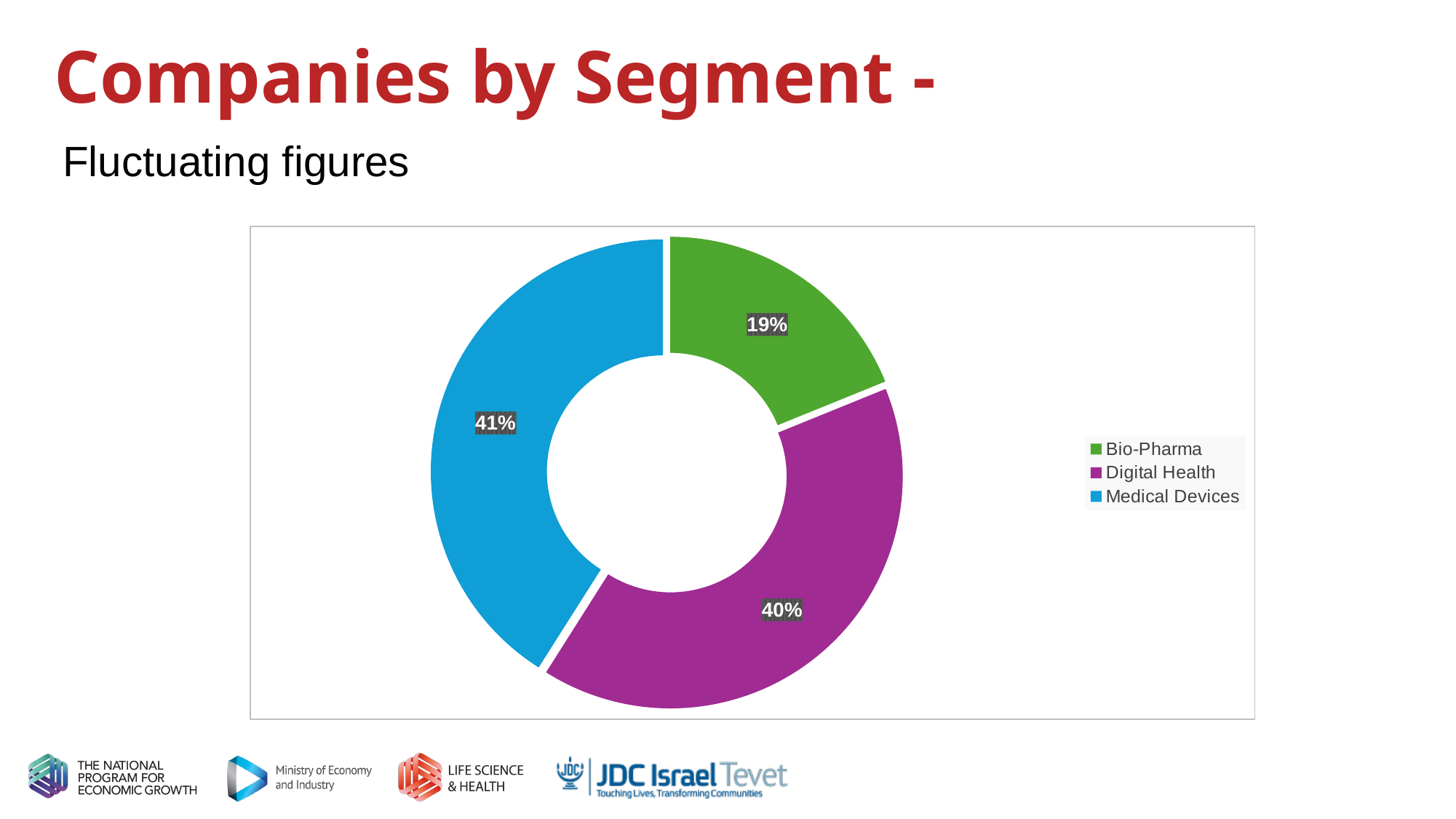
Which segment has the largest share of companies? Medical Devices Which segment has a larger share, Digital Health or Bio-Pharma? Digital Health Which segment has the smallest share of companies? Bio-Pharma How many segments are shown in the chart? 3 What is the difference in percentage points between the Medical Devices and Bio-Pharma shares? 22 What share of companies is in the Bio-Pharma segment? 19% What share of companies is in the Medical Devices segment? 41% What colour represents the Digital Health segment? Purple What is the difference in percentage points between the Digital Health and Bio-Pharma shares? 21 What kind of chart is shown on the slide? Doughnut chart What share of companies is in the Digital Health segment? 40% How many entries does the legend list? 3